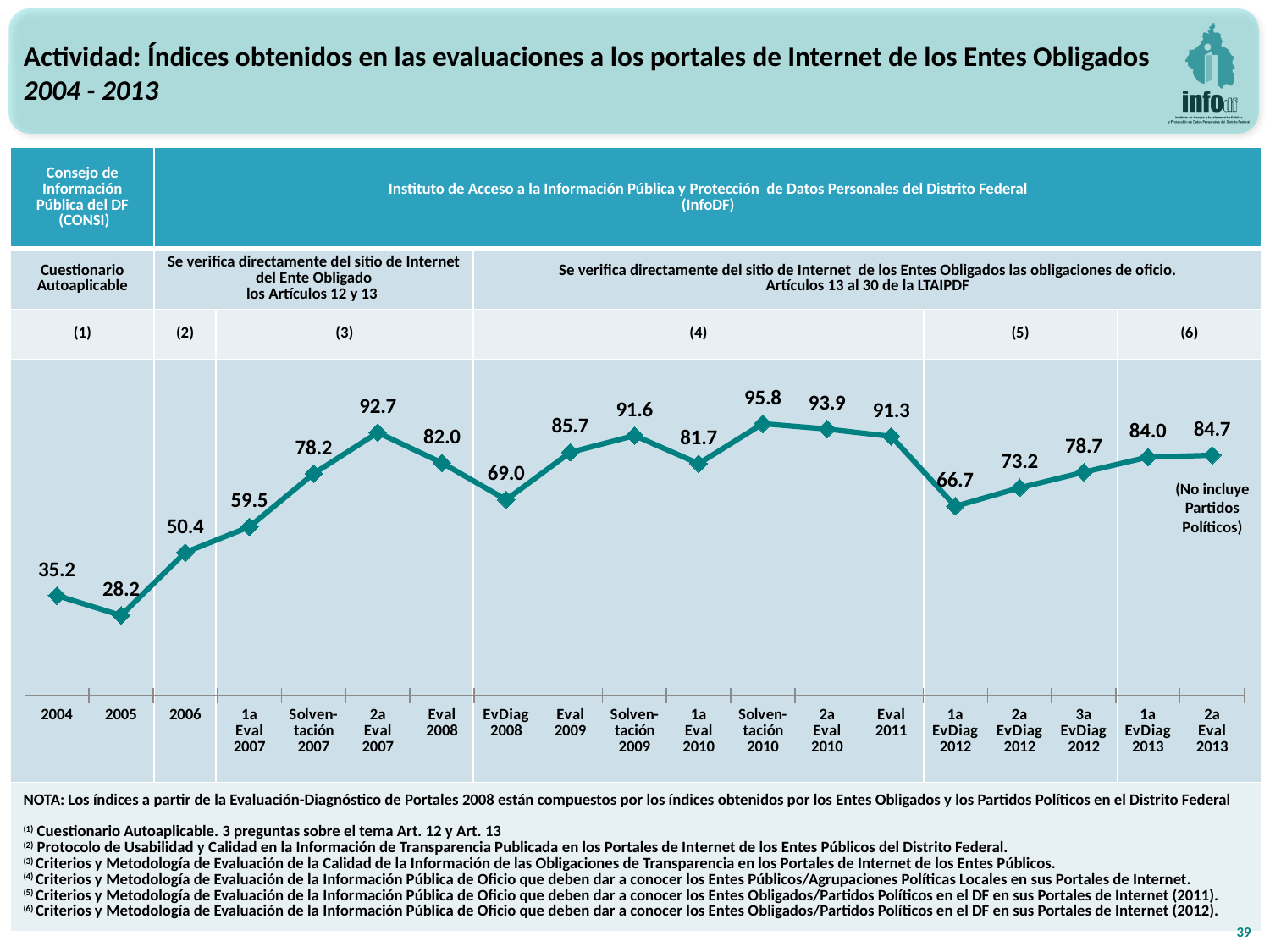
What is the value for Solventación 2010? 95.8 What is the difference between the values for 2006 and 2005? 22.2 What is the value for 2004? 35.2 Which point has the lowest value? 2005 Do the values rise or fall from 1a EvDiag 2012 to 2a Eval 2013? Rise What kind of chart is shown on the slide? Line chart How many data points are plotted on the chart? 19 What is the difference between the values for 2a Eval 2007 and Eval 2008? 10.7 What is the value for 2a Eval 2013? 84.7 Which point has the highest value? Solventación 2010 What is the value for EvDiag 2008? 69.0 Which is larger, the value for 1a Eval 2010 or the value for Eval 2009? Eval 2009